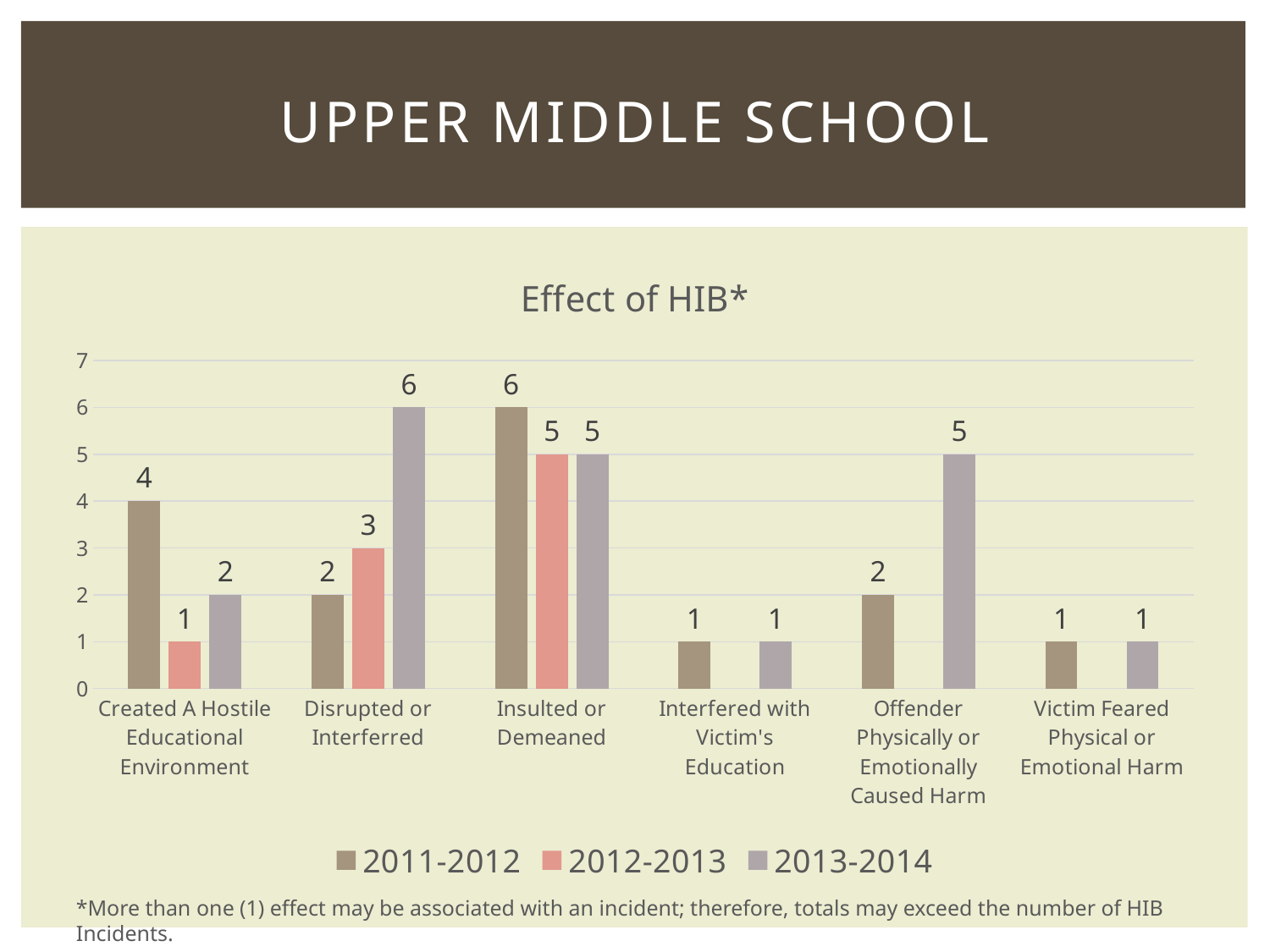
What kind of chart is shown on the slide? Bar chart How many categories are shown on the x axis? 6 What is the value for 2012-2013 in the Insulted or Demeaned category? 5 What is the title of the chart? Effect of HIB* What is the difference between the 2013-2014 and 2011-2012 values in the Disrupted or Interferred category? 4 What is the value for 2011-2012 in the Created A Hostile Educational Environment category? 4 Which is larger in the Created A Hostile Educational Environment category: the 2011-2012 value or the 2013-2014 value? 2011-2012 What is the value for 2013-2014 in the Offender Physically or Emotionally Caused Harm category? 5 What is the value for 2013-2014 in the Disrupted or Interferred category? 6 Which category has the highest value for 2013-2014? Disrupted or Interferred How many series does the legend list? 3 Which category has the highest value for 2011-2012? Insulted or Demeaned